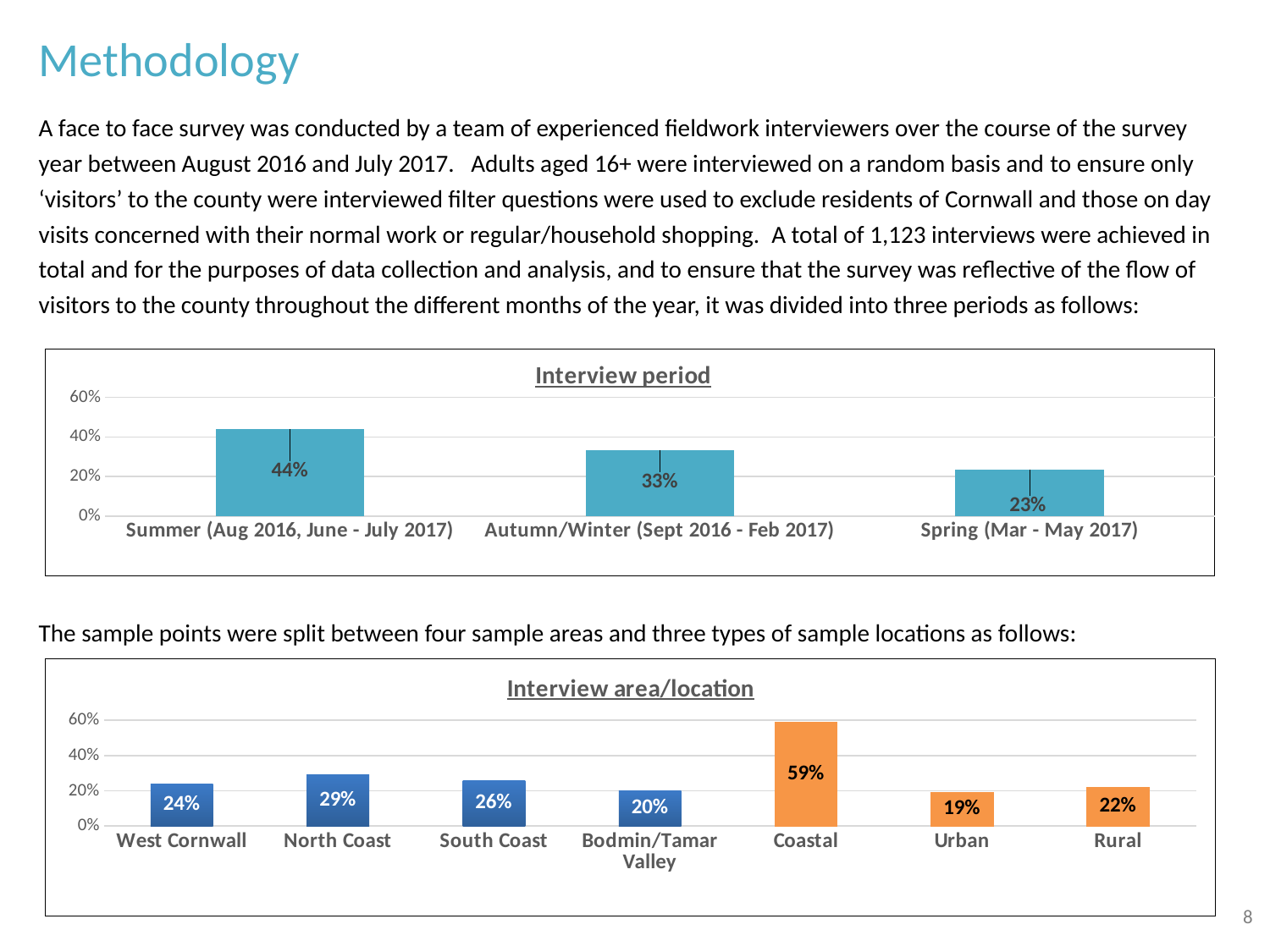
In the 'Interview area/location' chart, which is larger, South Coast or Bodmin/Tamar Valley? South Coast In the 'Interview period' chart, what is the value for Summer (Aug 2016, June - July 2017)? 44% In the 'Interview period' chart, how many interview periods are shown? 3 What type of chart is the 'Interview area/location' chart? bar chart In the 'Interview period' chart, what is the difference between the Summer and Spring values? 21% In the 'Interview period' chart, which interview period has the lowest value? Spring (Mar - May 2017) In the 'Interview area/location' chart, which category has the highest value? Coastal In the 'Interview area/location' chart, what is the value for North Coast? 29% In the 'Interview area/location' chart, how many categories are shown? 7 In the 'Interview area/location' chart, what is the difference between Coastal and Rural? 37% In the 'Interview period' chart, do the values rise or fall from left to right? fall In the 'Interview area/location' chart, which category has the lowest value? Urban